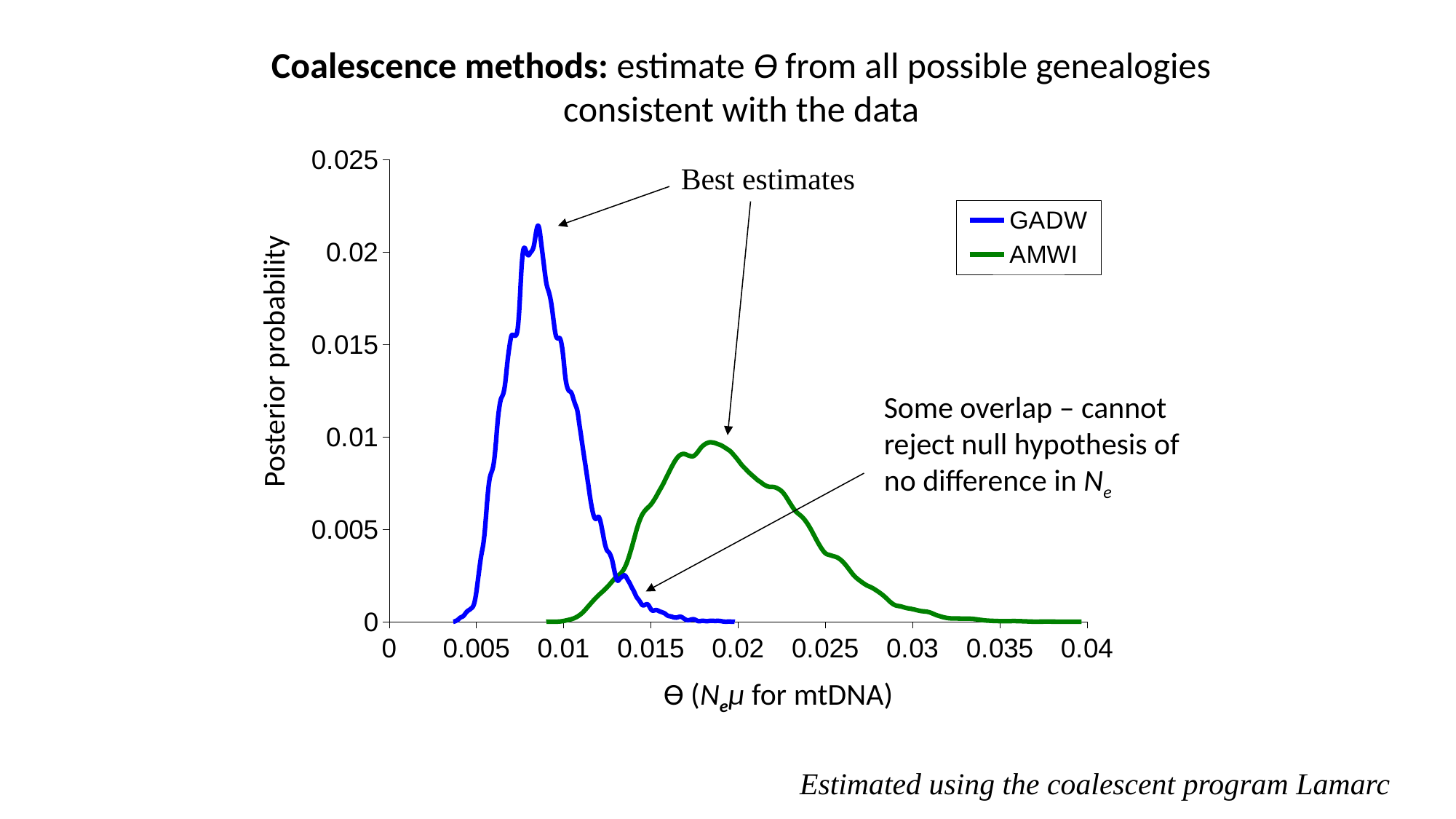
Which series peaks at a larger value of Θ, GADW or AMWI? AMWI What are the two series named in the legend? GADW and AMWI Is the Θ value at which the AMWI curve peaks greater or less than 0.015? greater Is the peak posterior probability of the GADW curve greater or less than 0.02? greater What is the maximum value shown on the x axis? 0.04 What is the label of the y axis? Posterior probability What kind of chart is shown on the slide? line chart How many series does the legend list? 2 Is the Θ value at which the GADW curve peaks greater or less than 0.01? less Which series has the higher peak posterior probability, GADW or AMWI? GADW